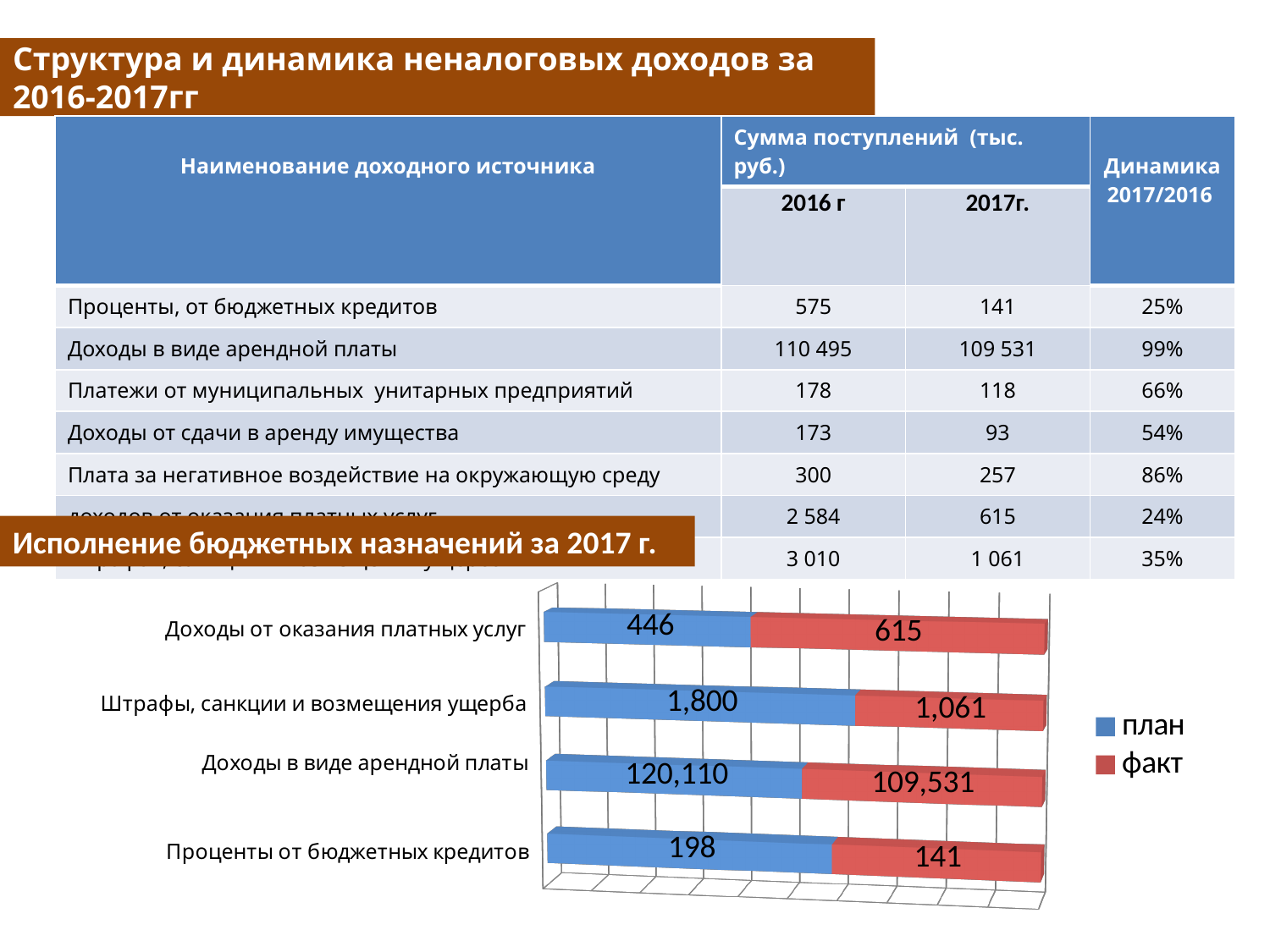
Which category has the lowest факт value in the chart? Проценты от бюджетных кредитов In the chart, which is larger for Доходы от оказания платных услуг: план or факт? факт How many categories are shown in the chart? 4 What is the difference between план and факт for Проценты от бюджетных кредитов in the chart? 57 How many series does the chart legend list? 2 What kind of chart is shown on the slide? bar chart What is the факт value for Проценты от бюджетных кредитов in the chart? 141 What is the план value for Штрафы, санкции и возмещения ущерба in the chart? 1,800 What is the план value for Доходы от оказания платных услуг in the chart? 446 Which category has the highest план value in the chart? Доходы в виде арендной платы What is the difference between план and факт for Штрафы, санкции и возмещения ущерба in the chart? 739 What is the факт value for Доходы в виде арендной платы in the chart? 109,531